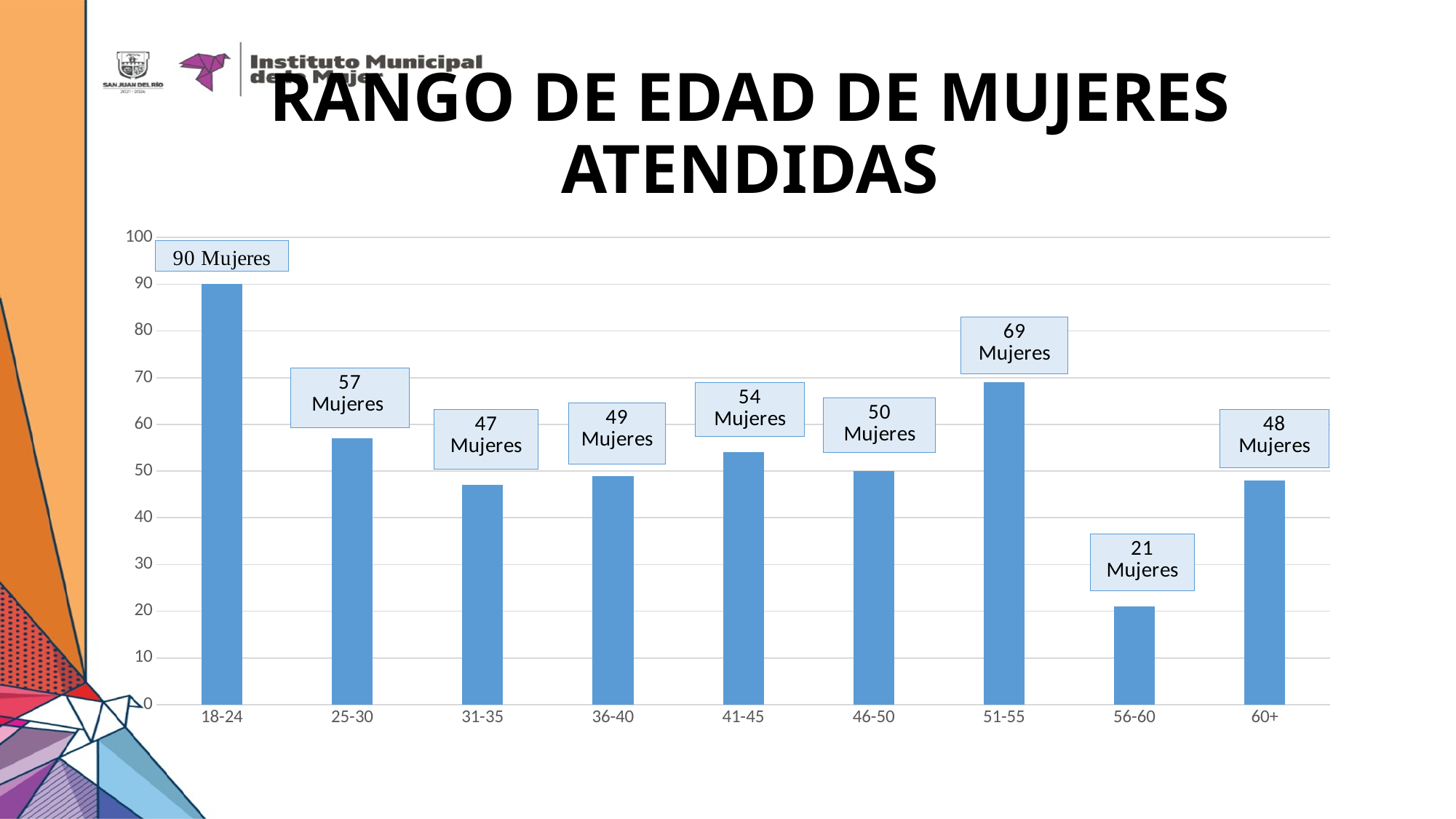
What is the title of the slide? RANGO DE EDAD DE MUJERES ATENDIDAS Which age range has the lowest number of women attended? 56-60 Which has a larger value, 60+ or 36-40? 36-40 What is the difference between the values for 25-30 and 56-60? 36 What is the value shown for the 51-55 age range? 69 Mujeres What is the difference between the values for 18-24 and 51-55? 21 What kind of chart is shown on the slide? Bar chart Which has a larger value, 41-45 or 46-50? 41-45 How many women were attended in the 18-24 age range? 90 Mujeres What is the value shown for the 56-60 age range? 21 Mujeres How many age ranges are shown on the x axis? 9 Which age range has the highest number of women attended? 18-24